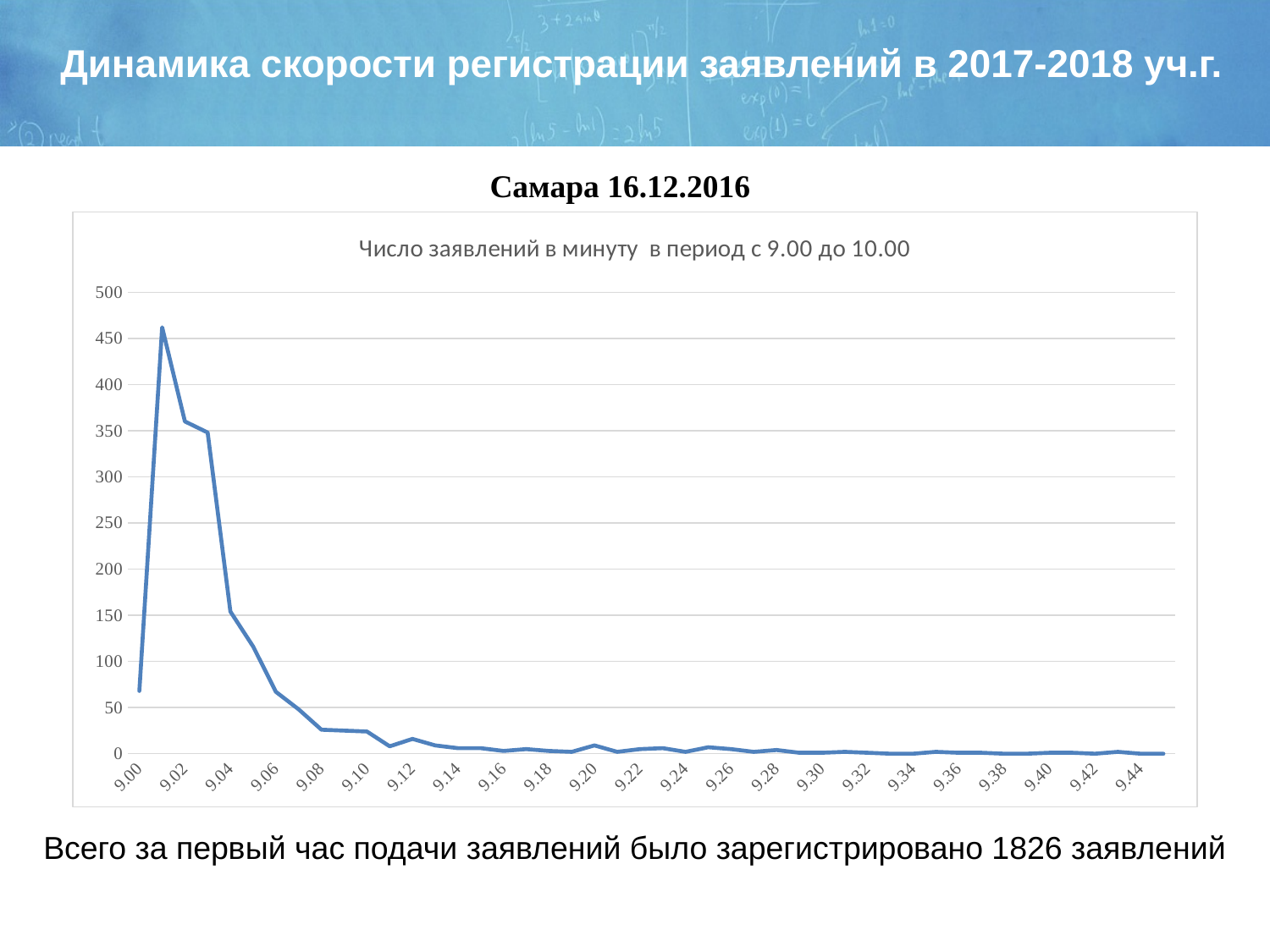
What kind of chart is shown on the slide? line chart Is the value at 9.08 greater or less than 50? less What is the title printed inside the chart area? Число заявлений в минуту в период с 9.00 до 10.00 Which is larger, the value at 9.02 or the value at 9.04? 9.02 After the peak near the start, do the values generally rise or fall along the x axis? fall Is the value at 9.02 greater or less than 300? greater What city and date are given above the chart? Самара 16.12.2016 Is the value at 9.04 greater or less than 100? greater Which is larger, the value at 9.00 or the value at 9.08? 9.00